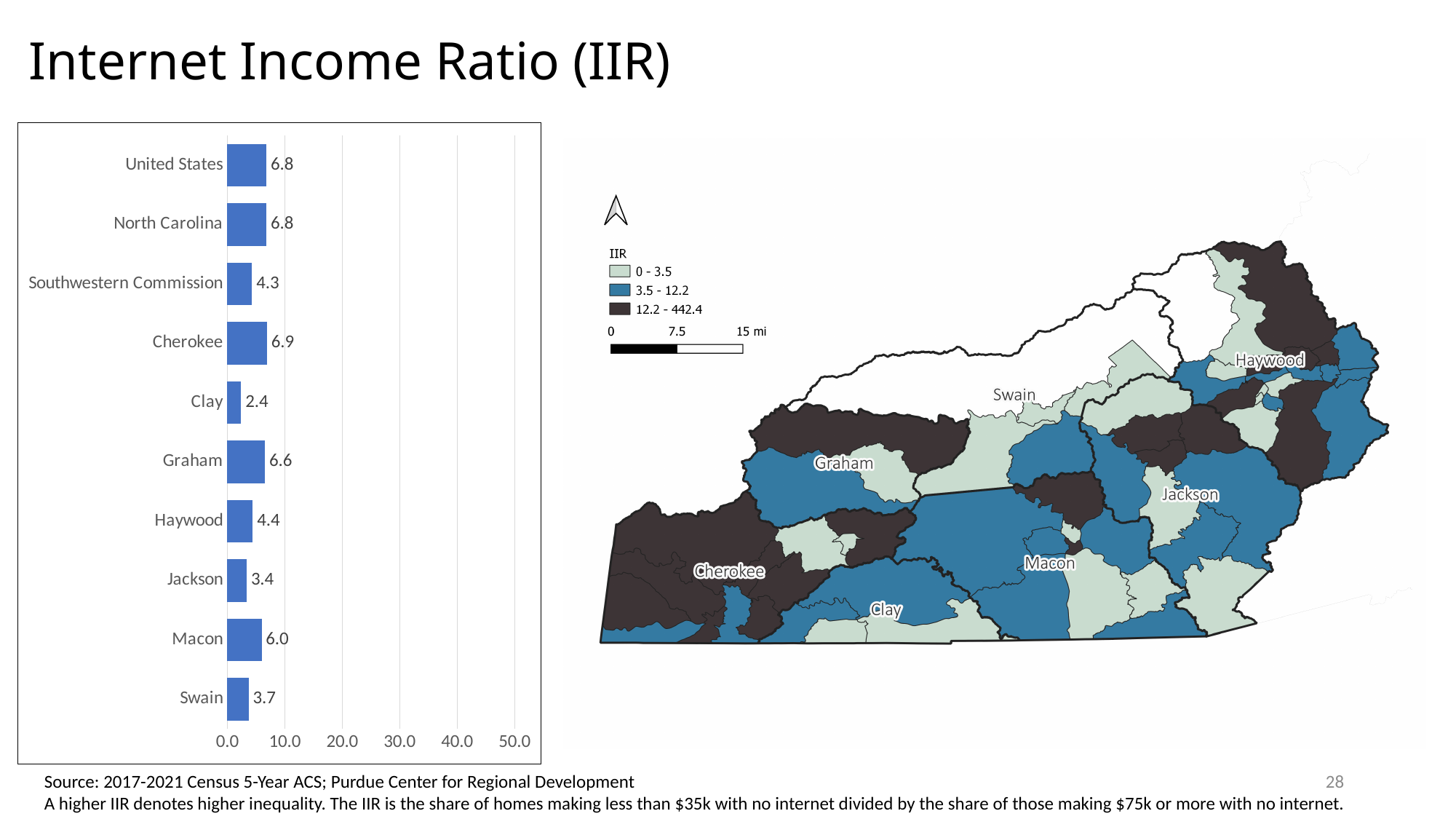
Which has a larger IIR value in the bar chart, Graham or Haywood? Graham Is the IIR value for Clay in the bar chart greater or less than 10.0? less What kind of chart is shown on the left of the slide? Bar chart What is the IIR value for Swain in the bar chart? 3.7 What is the IIR value for the Southwestern Commission in the bar chart? 4.3 What is the difference between the IIR values for Macon and Jackson in the bar chart? 2.6 What is the highest value shown on the x axis of the bar chart? 50.0 What is the difference between the IIR values for the United States and Clay in the bar chart? 4.4 Which category has the highest IIR value in the bar chart? Cherokee What is the IIR value for Cherokee in the bar chart? 6.9 How many categories are shown in the bar chart? 10 Which category has the lowest IIR value in the bar chart? Clay